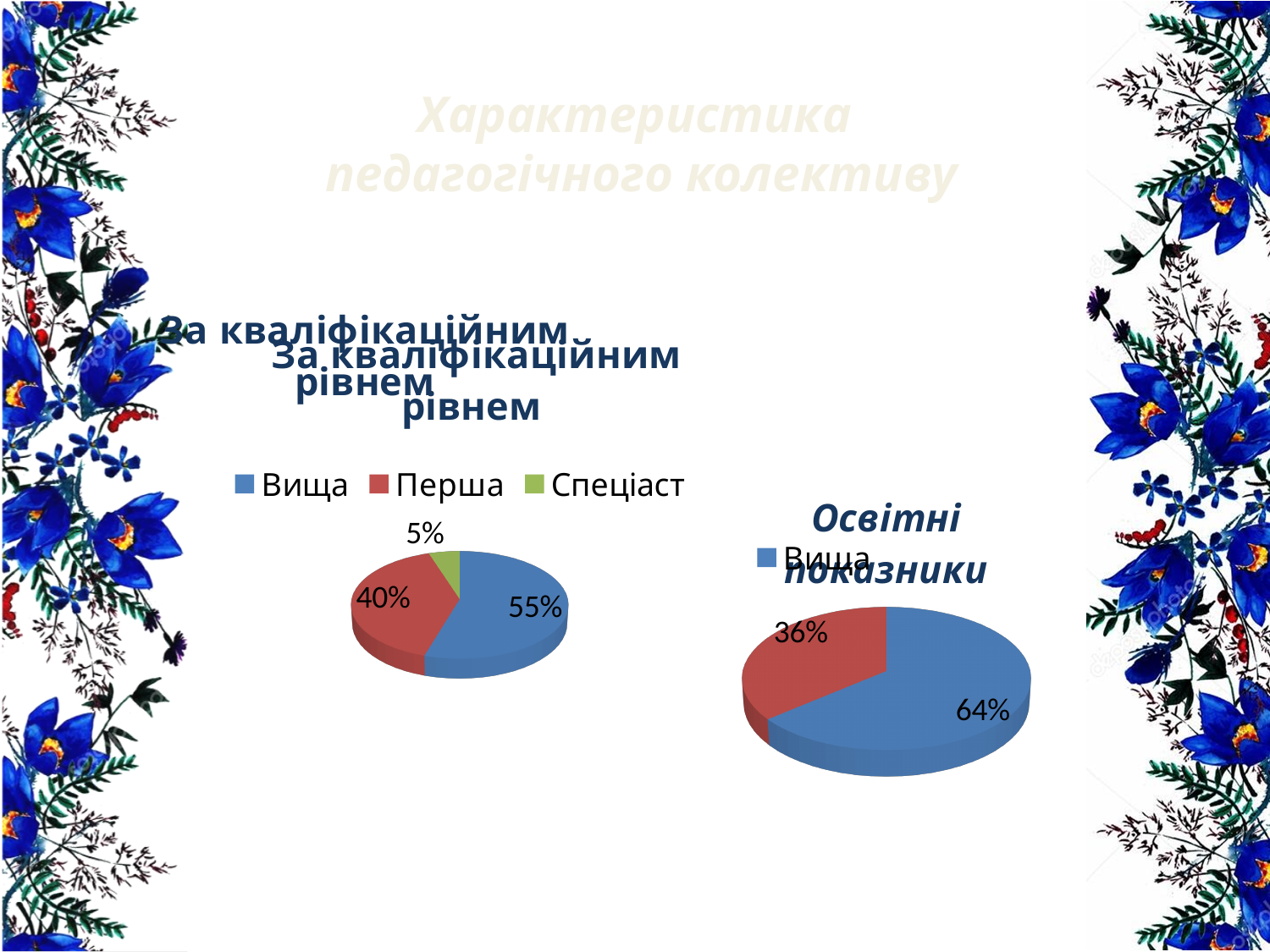
In the chart titled "За кваліфікаційним рівнем", which category has the smallest share? Спеціаст In the chart titled "Освітні показники", what percentage is shown for the blue slice (Вища)? 64% What type of chart is the one titled "За кваліфікаційним рівнем"? pie chart How many pie charts are shown on the slide? 2 In the chart titled "За кваліфікаційним рівнем", what percentage is shown for Перша? 40% In the chart titled "За кваліфікаційним рівнем", which category has the largest share? Вища In the chart titled "За кваліфікаційним рівнем", what percentage is shown for Вища? 55% In the chart titled "За кваліфікаційним рівнем", what percentage is shown for Спеціаст? 5% In the chart titled "За кваліфікаційним рівнем", how many categories does the legend list? 3 In the chart titled "Освітні показники", what percentage is shown for the red slice? 36% In the chart titled "За кваліфікаційним рівнем", what is the difference in percentage points between Вища and Перша? 15 In the chart titled "Освітні показники", is the share for Вища larger or smaller than the red slice? larger